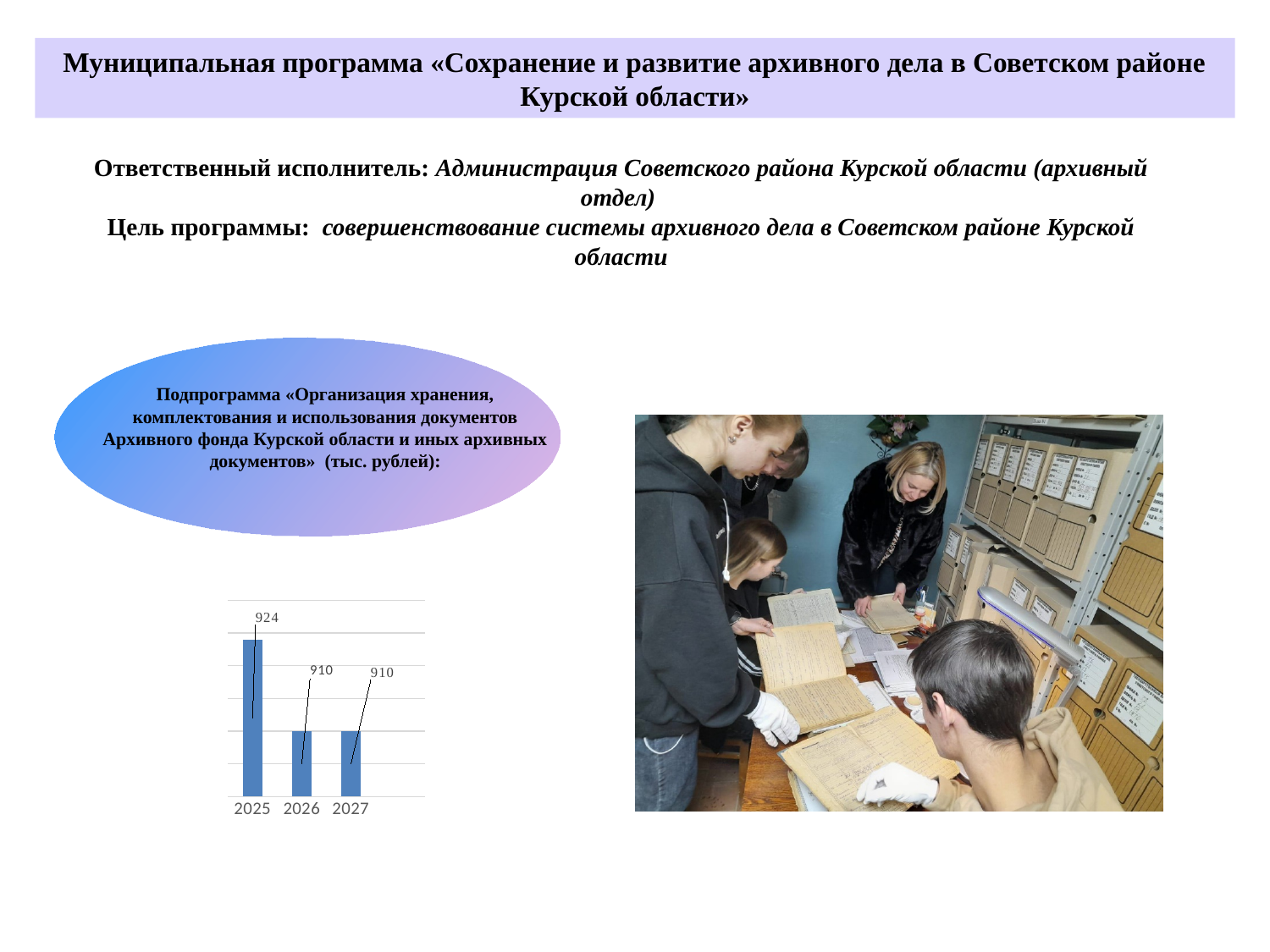
Do the values in the bar chart rise or fall from 2025 to 2026? fall Which is larger in the bar chart, the value for 2025 or the value for 2027? 2025 Which year has the highest value in the bar chart? 2025 What is the value for 2025 in the bar chart? 924 What is the difference between the values for 2025 and 2026 in the bar chart? 14 What kind of chart is shown on the slide? bar chart What is the value for 2027 in the bar chart? 910 Are the values for 2026 and 2027 in the bar chart equal? yes What is the value for 2026 in the bar chart? 910 What is the total of the values for 2025, 2026 and 2027 in the bar chart? 2744 What colour are the bars in the chart? blue How many years are shown on the x axis of the bar chart? 3